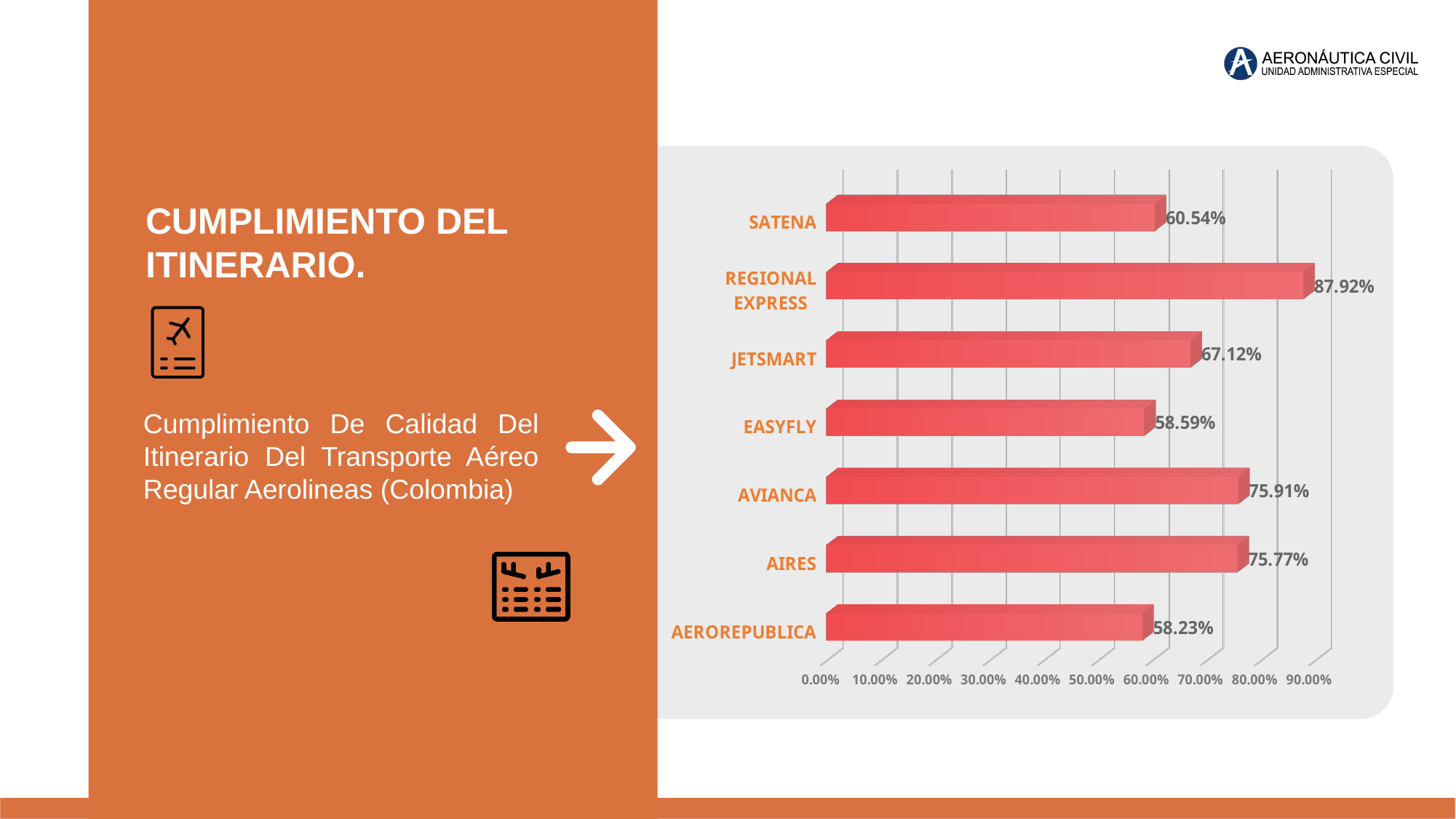
What is the value shown for AEROREPUBLICA? 58.23% Which airline has the lowest value in the chart? AEROREPUBLICA What is the difference between the values for REGIONAL EXPRESS and SATENA? 27.38% Is the value for AIRES greater or less than 70.00%? greater Which airline has the highest value in the chart? REGIONAL EXPRESS What is the value shown for AVIANCA? 75.91% Which has a larger value, JETSMART or SATENA? JETSMART How many airlines are shown in the chart? 7 What is the value shown for REGIONAL EXPRESS? 87.92% What is the value shown for SATENA? 60.54% What kind of chart is shown on the slide? bar chart What is the difference between the values for JETSMART and EASYFLY? 8.53%